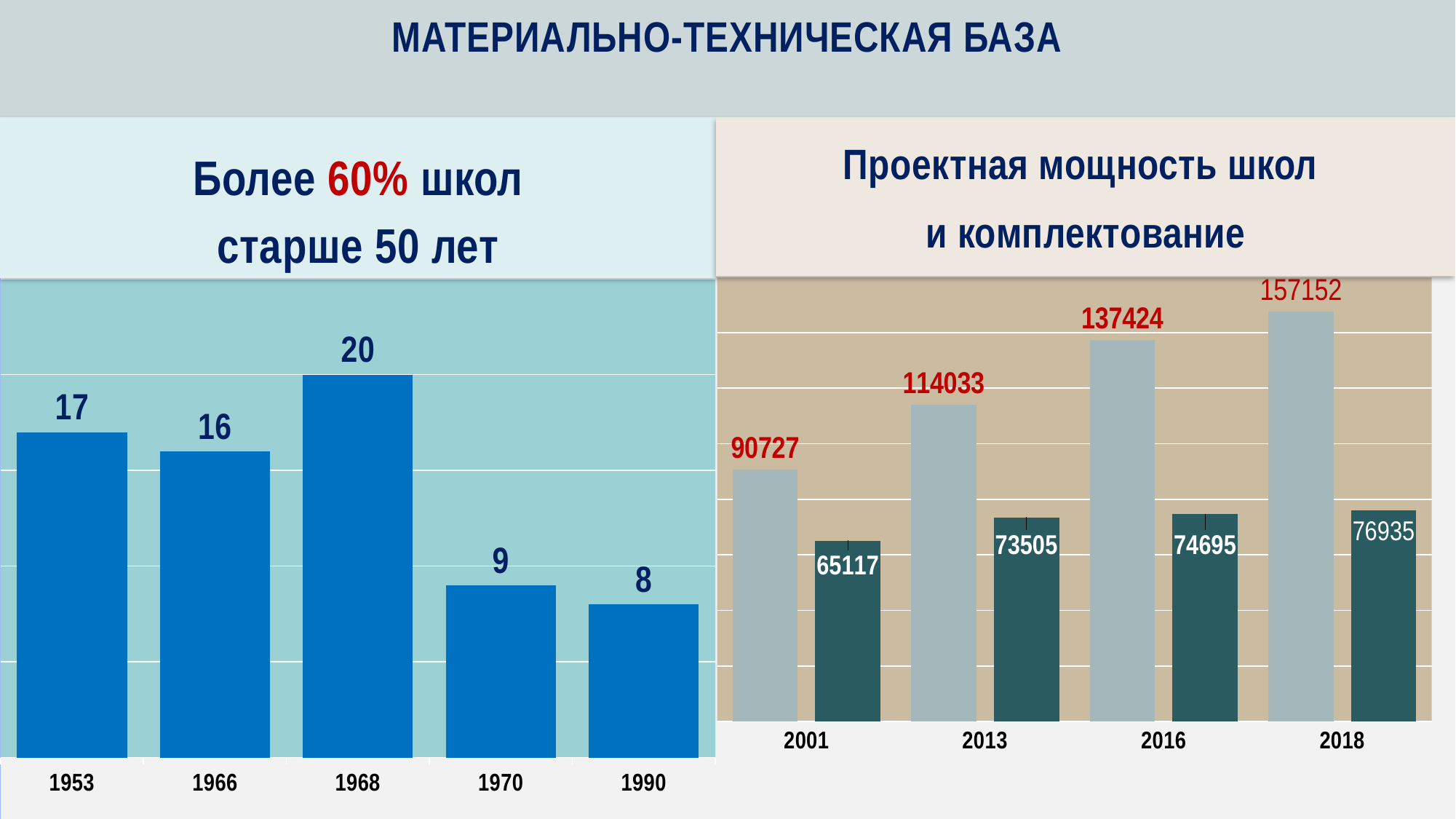
In the right chart ("Проектная мощность школ и комплектование"), how many years are shown on the x axis? 4 In the left chart ("Более 60% школ старше 50 лет"), which year has the lowest value? 1990 In the right chart ("Проектная мощность школ и комплектование"), do the light grey bar values rise or fall from 2001 to 2018? rise In the right chart ("Проектная мощность школ и комплектование"), what is the value of the light grey bar for 2016? 137424 In the left chart ("Более 60% школ старше 50 лет"), which is larger, the value for 1953 or the value for 1966? 1953 In the left chart ("Более 60% школ старше 50 лет"), what is the difference between the values for 1953 and 1970? 8 In the left chart ("Более 60% школ старше 50 лет"), what is the value for 1968? 20 In the left chart ("Более 60% школ старше 50 лет"), which year has the highest value? 1968 What kind of chart is the left chart ("Более 60% школ старше 50 лет")? bar chart In the left chart ("Более 60% школ старше 50 лет"), how many years are shown on the x axis? 5 In the right chart ("Проектная мощность школ и комплектование"), what is the difference between the light grey and dark teal bars for 2018? 80217 In the right chart ("Проектная мощность школ и комплектование"), what is the value of the dark teal bar for 2001? 65117